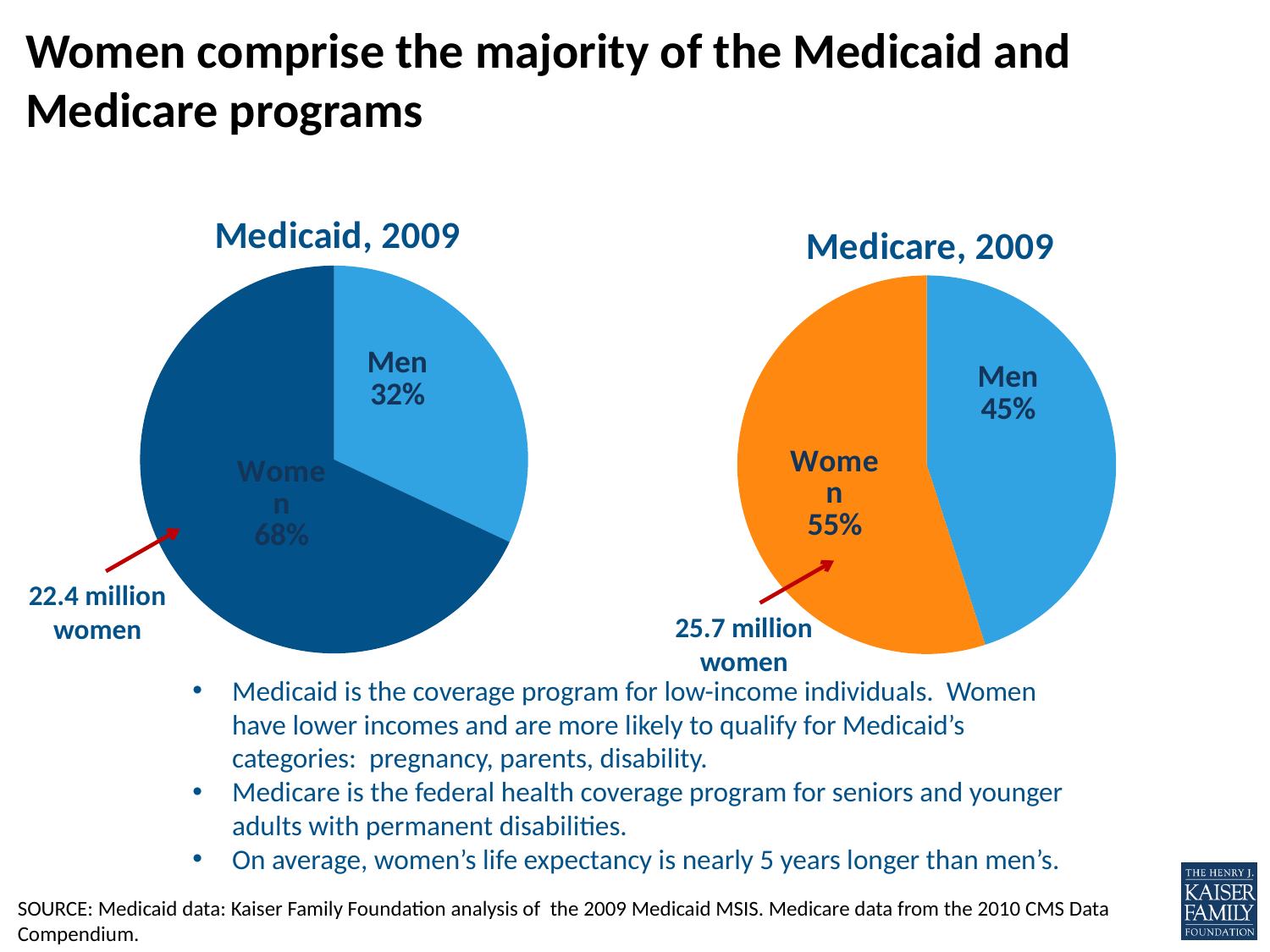
In the Medicare, 2009 chart, what share of the pie is Women? 55% What kind of chart is the Medicare, 2009 chart? Pie chart In the Medicaid, 2009 chart, what is the difference in percentage points between the Women and Men slices? 36 Which is larger: the Women share in the Medicaid, 2009 chart or the Women share in the Medicare, 2009 chart? Medicaid, 2009 In the Medicare, 2009 chart, what is the difference in percentage points between the Women and Men slices? 10 How many slices does the Medicaid, 2009 pie chart have? 2 According to the annotation on the Medicare, 2009 chart, how many women are in the program? 25.7 million women In the Medicare, 2009 chart, which slice is the smallest? Men In the Medicaid, 2009 chart, what share of the pie is Women? 68% In the Medicaid, 2009 chart, what share of the pie is Men? 32% In the Medicaid, 2009 chart, which slice is the largest? Women